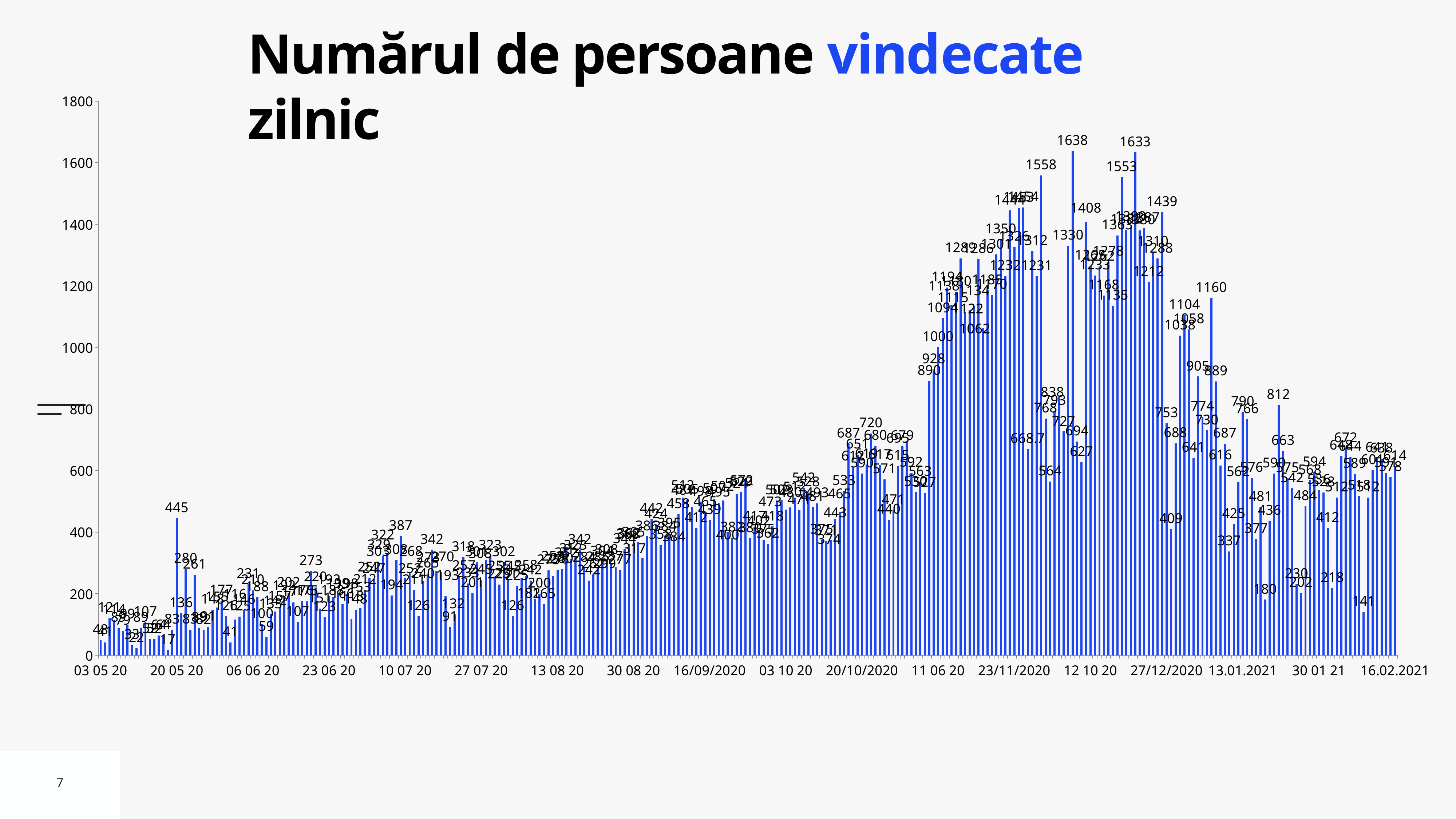
What is the difference between the bar labelled 1638 and the bar labelled 1558? 80 What is the highest value labelled before the 06 06 20 tick? 445 What is the difference between the two highest labelled values, 1638 and 1633? 5 Is the tallest bar in the chart greater or less than 1600? greater Do the values generally rise or fall from 03 05 20 to 23/11/2020? rise What is the lowest daily value labelled in the chart? 17 Do the values generally rise or fall from 23/11/2020 to 16.02.2021? fall What is the title of the chart? Numărul de persoane vindecate zilnic Which is larger, the bar labelled 1638 or the bar labelled 1558? 1638 Is the tallest bar near the 20 05 20 tick (labelled 445) greater or less than 400? greater What kind of chart is shown on the slide? bar chart What is the highest daily value shown in the chart? 1638